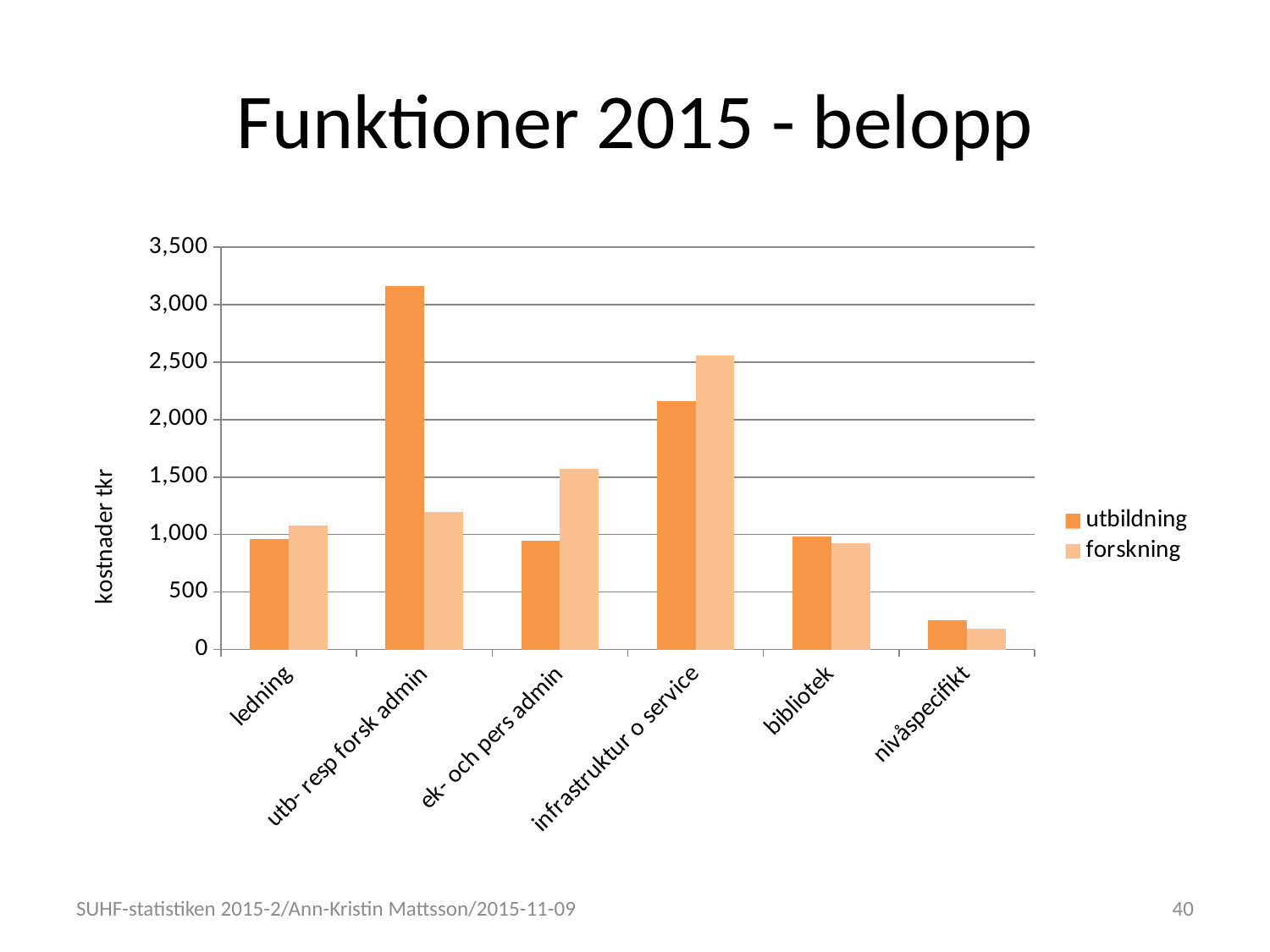
For utb- resp forsk admin, which is larger: utbildning or forskning? utbildning For ek- och pers admin, which is larger: utbildning or forskning? forskning How many series does the legend list? 2 Is the utbildning value for nivåspecifikt greater or less than 500? less Which category has the highest forskning value? infrastruktur o service Which category has the lowest utbildning value? nivåspecifikt What is the label of the y axis? kostnader tkr Which category has the lowest forskning value? nivåspecifikt What kind of chart is shown on the slide? bar chart Which category has the highest utbildning value? utb- resp forsk admin How many categories are shown on the x axis? 6 Is the utbildning value for utb- resp forsk admin greater or less than 3,000? greater